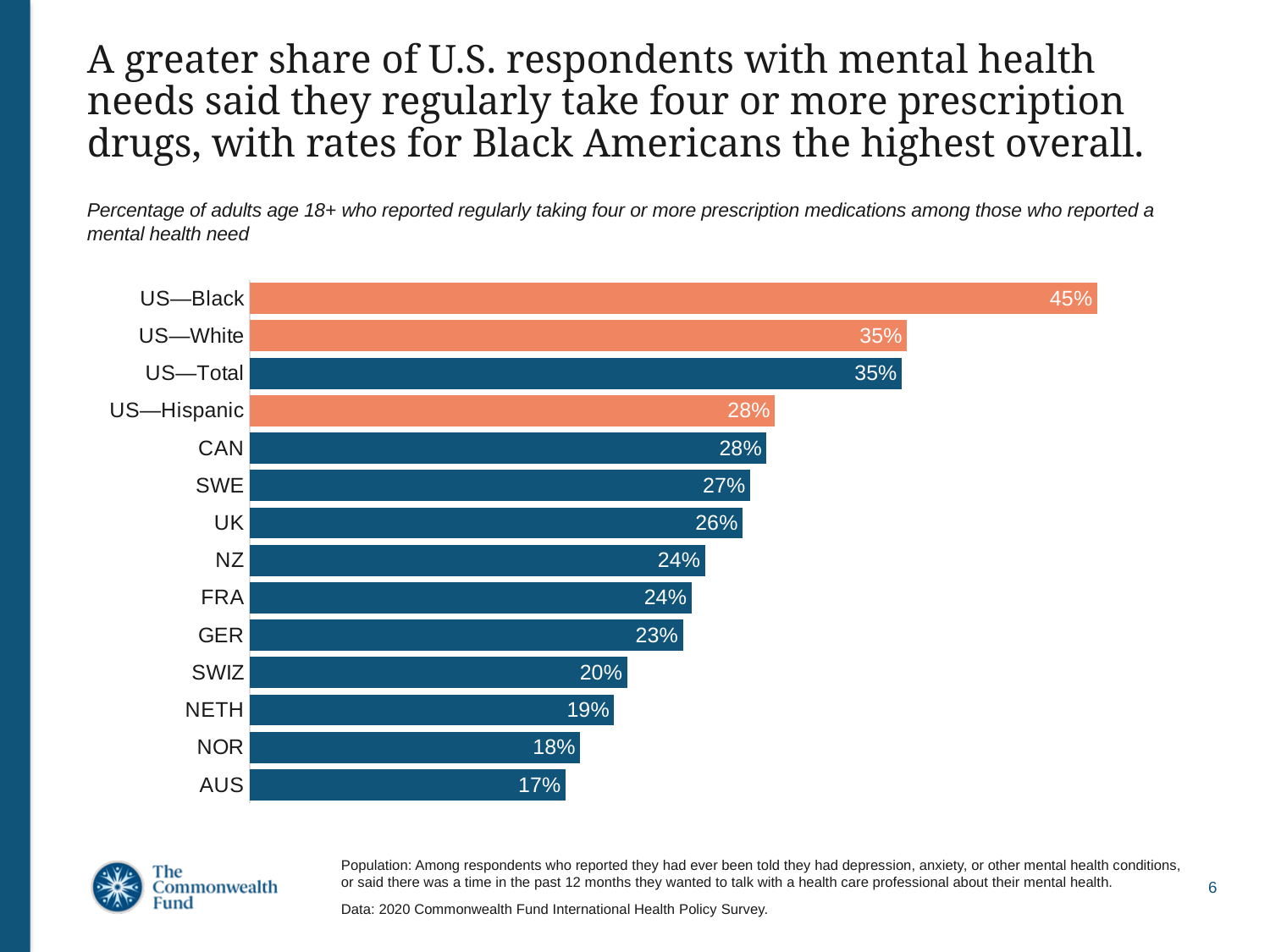
What is the value for CAN? 28% What is the value for NETH? 19% Which category has the lowest value? AUS What kind of chart is shown on the slide? Bar chart How many categories are shown in the chart? 14 Which categories are shown with orange bars? US—Black, US—White, US—Hispanic Which is larger, the value for UK or the value for GER? UK What is the difference between the values for SWE and NOR? 9 percentage points What is the value for US—Black? 45% Which is larger, the value for SWIZ or the value for NZ? NZ What is the difference between the values for US—Black and US—Hispanic? 17 percentage points Which category has the highest value? US—Black